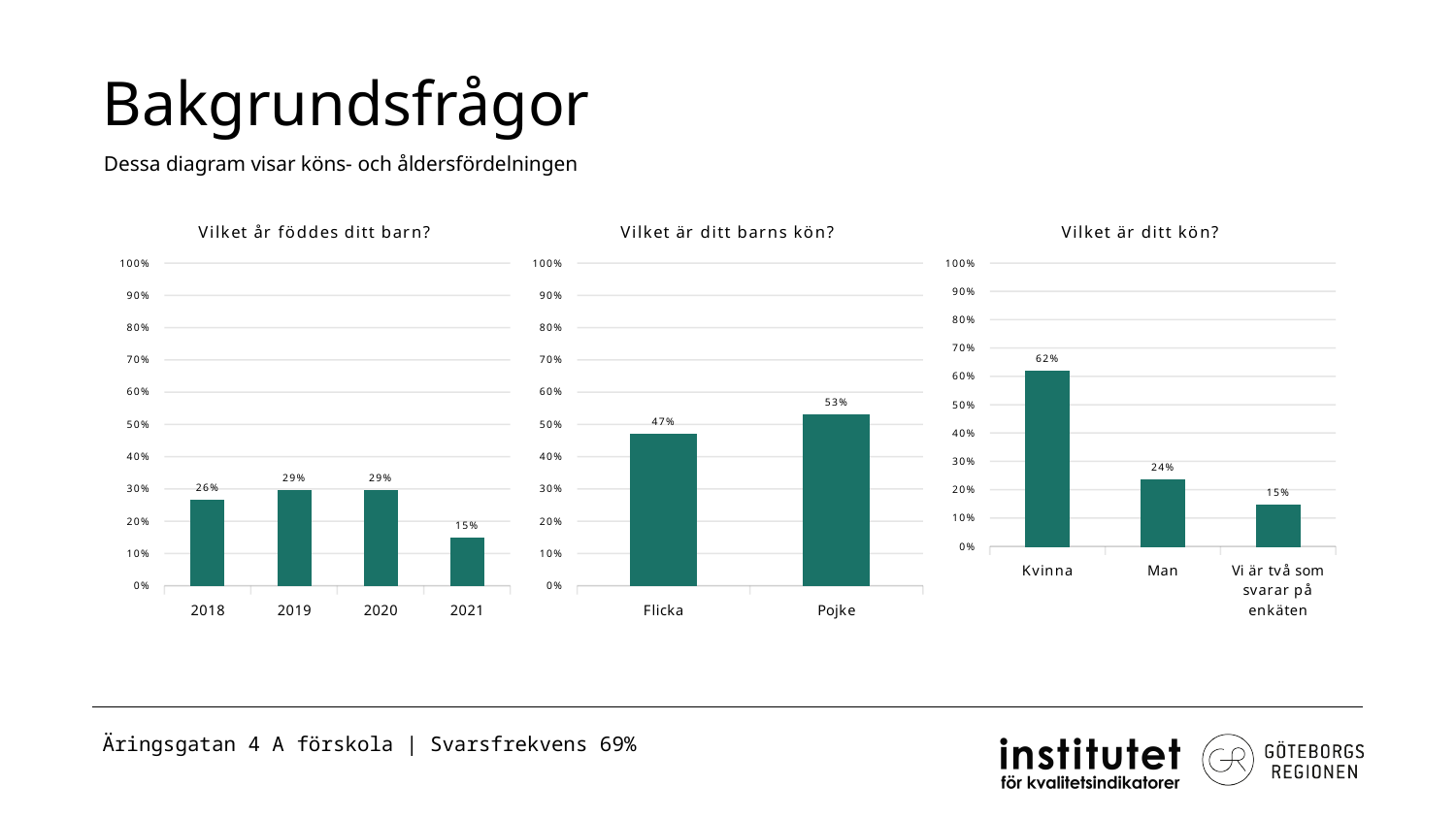
In the chart 'Vilket år föddes ditt barn?', what is the difference between the values for 2019 and 2021? 14% In the chart 'Vilket är ditt kön?', which category has the highest value? Kvinna What type of chart is 'Vilket är ditt kön?'? Bar chart In the chart 'Vilket är ditt kön?', what is the value for 'Vi är två som svarar på enkäten'? 15% In the chart 'Vilket är ditt kön?', what is the value for Man? 24% In the chart 'Vilket år föddes ditt barn?', which year has the lowest value? 2021 In the chart 'Vilket är ditt barns kön?', which is larger, Flicka or Pojke? Pojke How many categories are shown in the chart 'Vilket år föddes ditt barn?'? 4 In the chart 'Vilket år föddes ditt barn?', what is the value for 2018? 26% In the chart 'Vilket är ditt barns kön?', what is the difference between Pojke and Flicka? 6% In the chart 'Vilket är ditt kön?', is the value for Kvinna greater or less than 50%? greater In the chart 'Vilket är ditt barns kön?', what is the value for Pojke? 53%